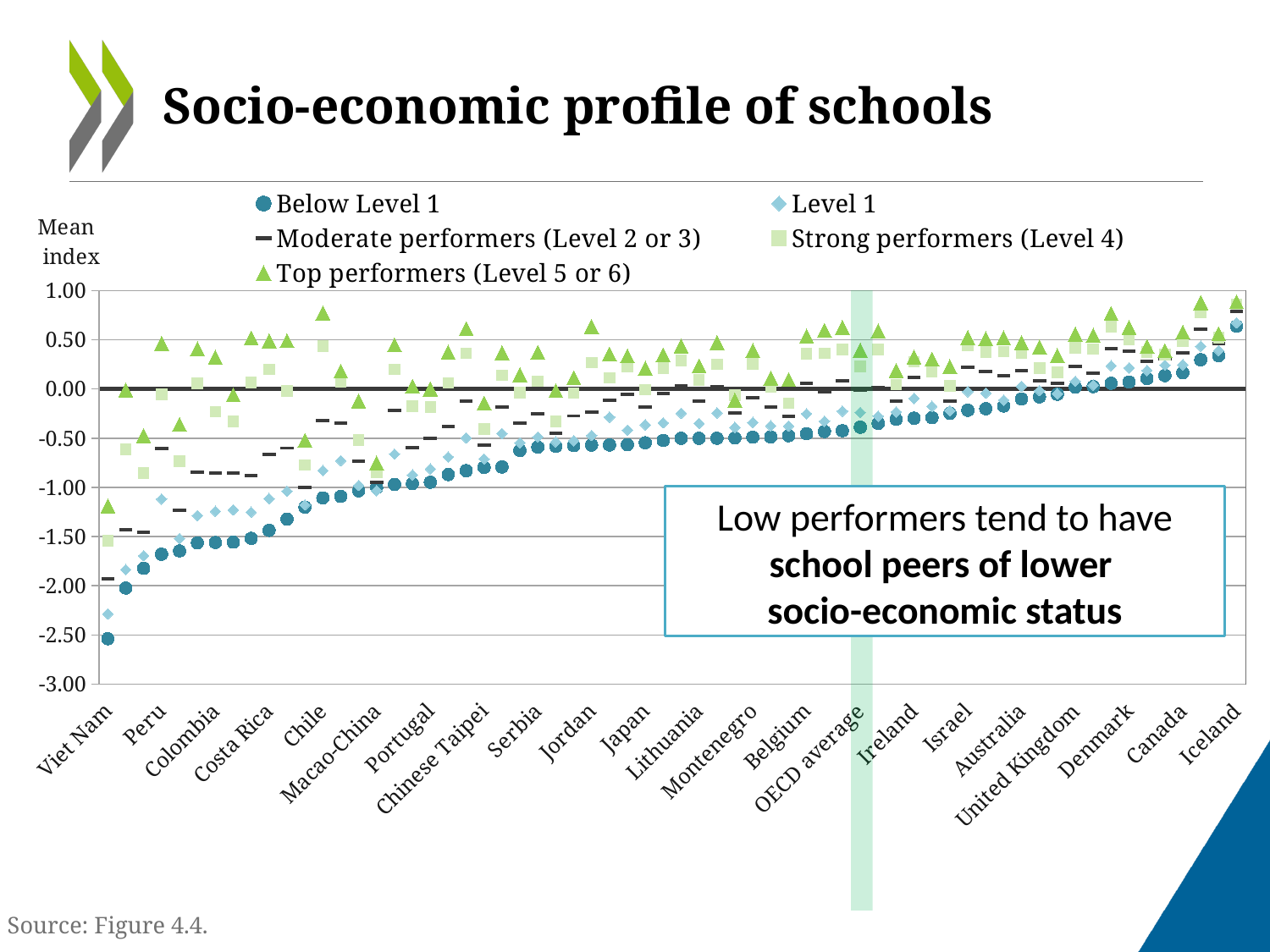
What kind of chart is shown on the slide? Scatter (dot) chart Is the Top performers (Level 5 or 6) value for Viet Nam greater or less than -1.00? less How many series does the legend list? 5 What is the title of the slide's chart? Socio-economic profile of schools Which country has the highest value for the Below Level 1 series? Iceland Is the Below Level 1 value for Iceland greater or less than 0.50? greater Which is larger, the Below Level 1 value for Viet Nam or the Below Level 1 value for Iceland? Iceland Is the Below Level 1 value for Viet Nam greater or less than -2.00? less Do the Below Level 1 values rise or fall from left to right along the x axis? Rise Which country has the lowest value for the Below Level 1 series? Viet Nam Which category is highlighted with a shaded vertical band on the chart? OECD average